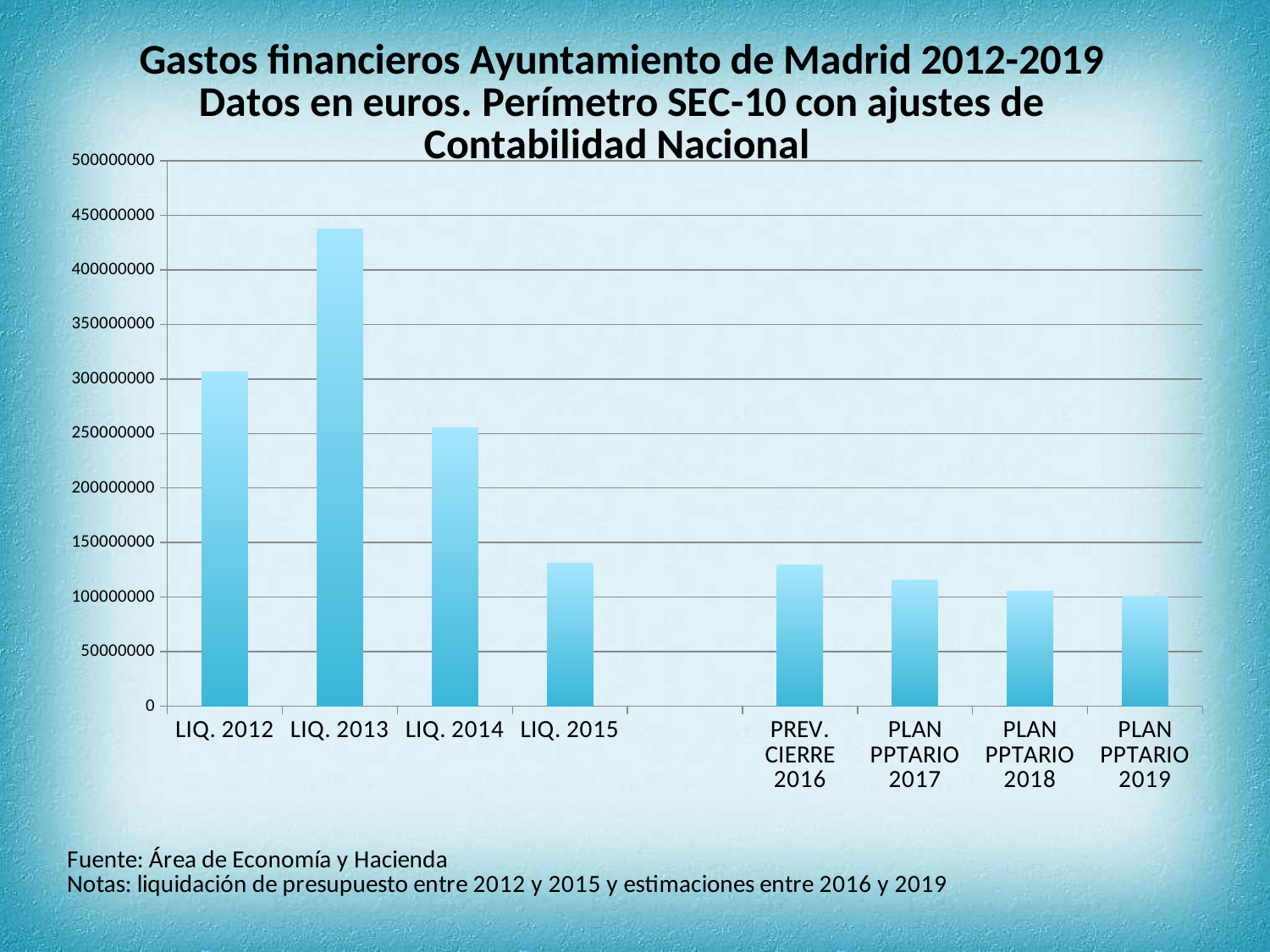
Which category has the highest value? LIQ. 2013 From LIQ. 2013 to PLAN PPTARIO 2019, do the values rise or fall? fall Is the value for LIQ. 2013 greater or less than 400000000? greater Is the value for LIQ. 2015 greater or less than 100000000? greater Is the value for LIQ. 2014 greater or less than 200000000? greater What is the highest value shown on the vertical axis? 500000000 Which is larger, the value for LIQ. 2012 or the value for LIQ. 2014? LIQ. 2012 How many bars are plotted in the chart? 8 Which is larger, the value for LIQ. 2014 or the value for PLAN PPTARIO 2017? LIQ. 2014 What kind of chart is shown on the slide? bar chart